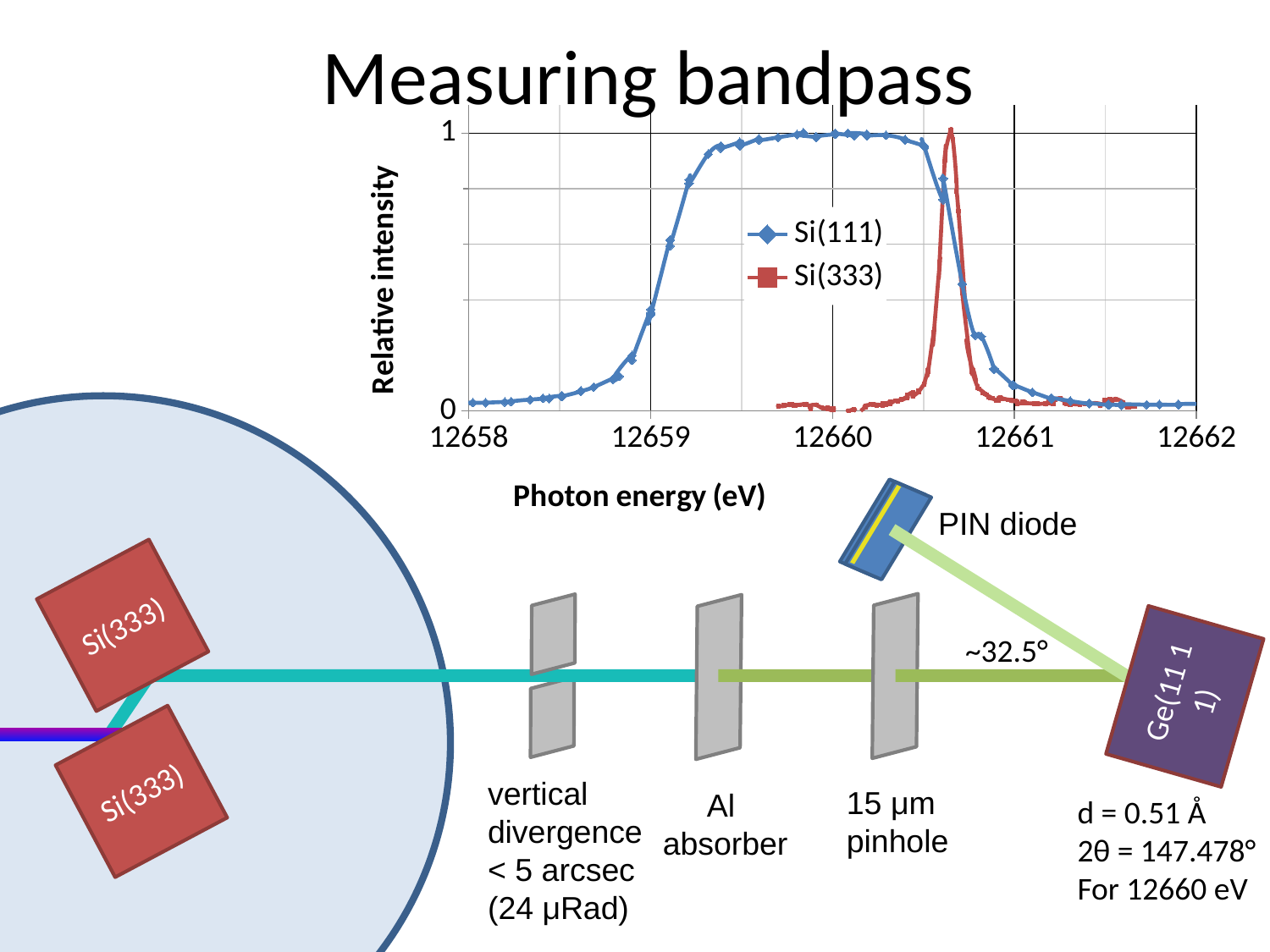
Is the relative intensity of Si(333) at 12660 eV greater or less than 0.5? less What is the label of the x axis of the chart? Photon energy (eV) Is the relative intensity of Si(111) at 12662 eV greater or less than 0.5? less Does the Si(111) curve rise or fall between 12658 eV and 12660 eV? rise At 12660 eV, which series has the higher relative intensity, Si(111) or Si(333)? Si(111) What kind of chart is shown on the slide? line chart How many series does the chart legend list? 2 What are the two series named in the chart legend? Si(111) and Si(333) Is the relative intensity of Si(111) at 12658 eV greater or less than 0.5? less Which series has the narrower peak, Si(111) or Si(333)? Si(333) Does the Si(111) curve rise or fall between 12661 eV and 12662 eV? fall